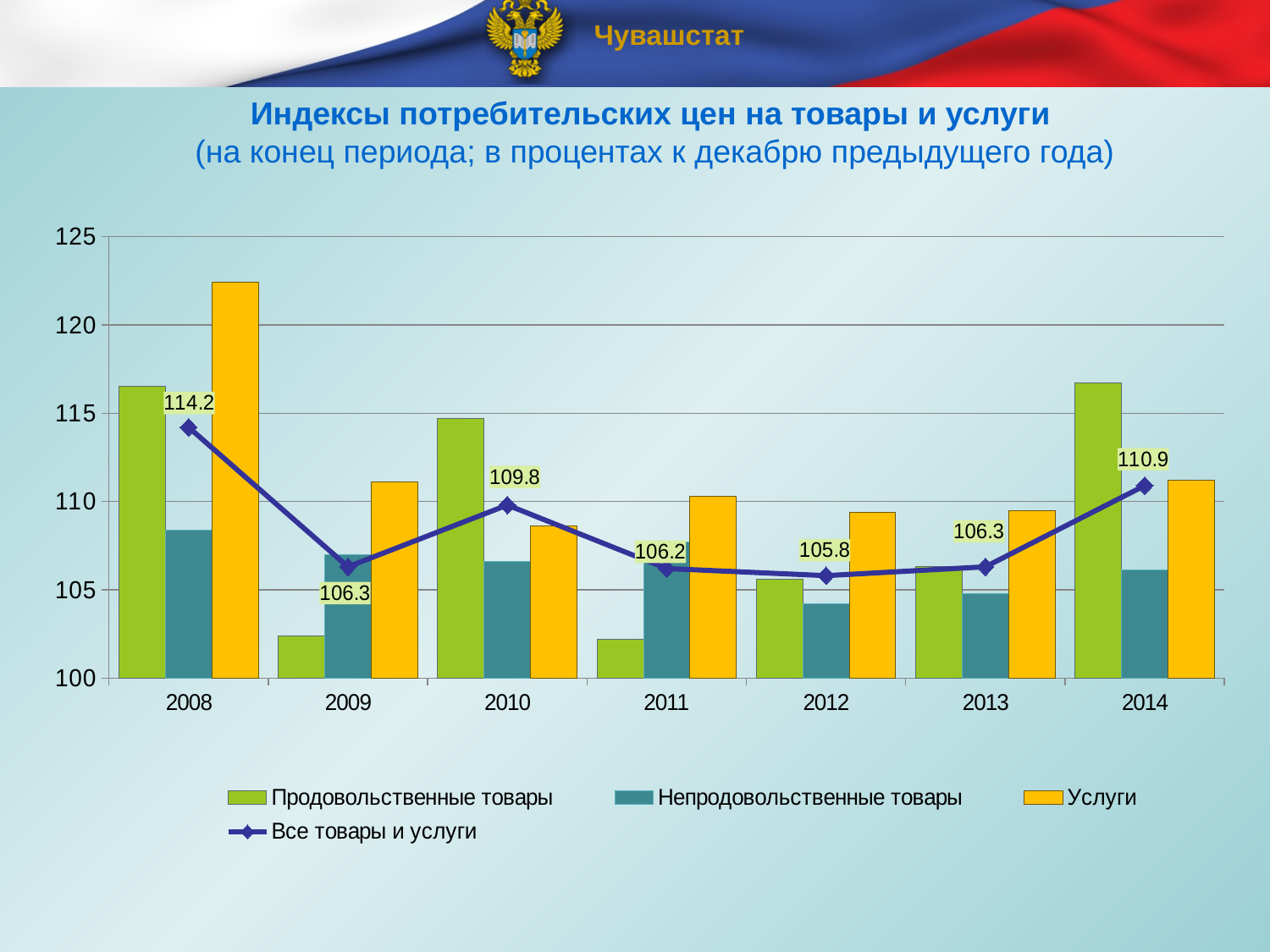
Does the 'Все товары и услуги' line rise or fall from 2012 to 2014? rises Is the 'Продовольственные товары' bar for 2009 greater or less than 105? less By how much does the 'Все товары и услуги' value for 2008 exceed the value for 2014? 3.3 How many years are shown on the x axis? 7 Which year has the larger 'Все товары и услуги' value, 2010 or 2011? 2010 In which year is the 'Все товары и услуги' line at its highest? 2008 Is the 'Услуги' bar for 2008 greater or less than 120? greater What is the value of the 'Все товары и услуги' line for 2014? 110.9 In which year is the 'Все товары и услуги' line at its lowest? 2012 What is the value of the 'Все товары и услуги' line for 2012? 105.8 What is the value of the 'Все товары и услуги' line for 2008? 114.2 How many series does the legend list? 4